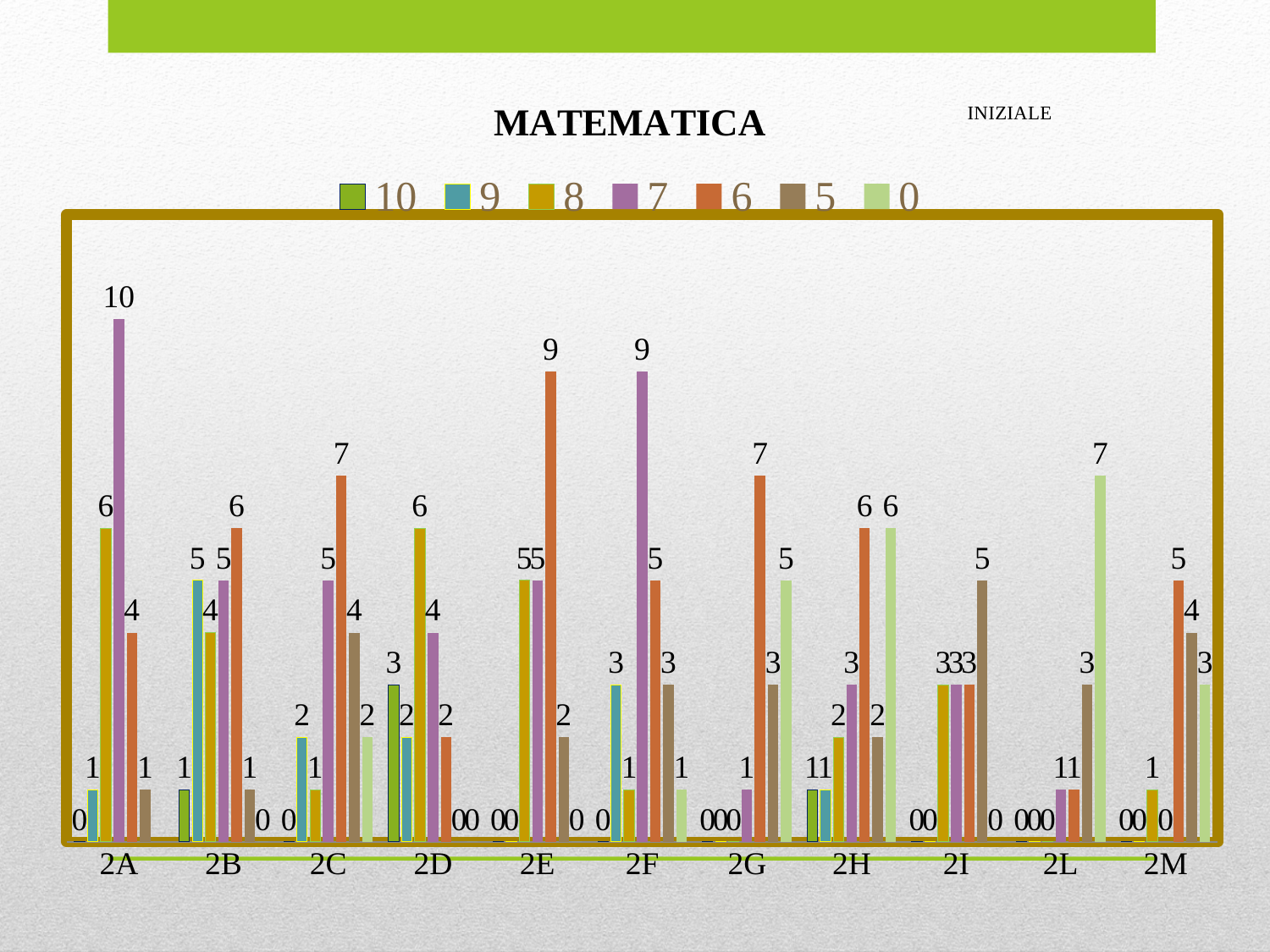
What is the value of series 6 for class 2C? 7 What kind of chart is shown on the slide? bar chart What is the title of the chart? MATEMATICA What is the value of series 7 for class 2A? 10 How many categories (classes) are shown on the x axis? 11 What is the value of series 6 for class 2E? 9 What is the difference between series 7 and series 8 for class 2A? 4 Which is larger: series 6 for class 2E or series 6 for class 2G? 2E How many series does the legend list? 7 What is the value of series 5 for class 2I? 5 What is the value of series 0 for class 2L? 7 Which class has the single highest bar in the chart? 2A